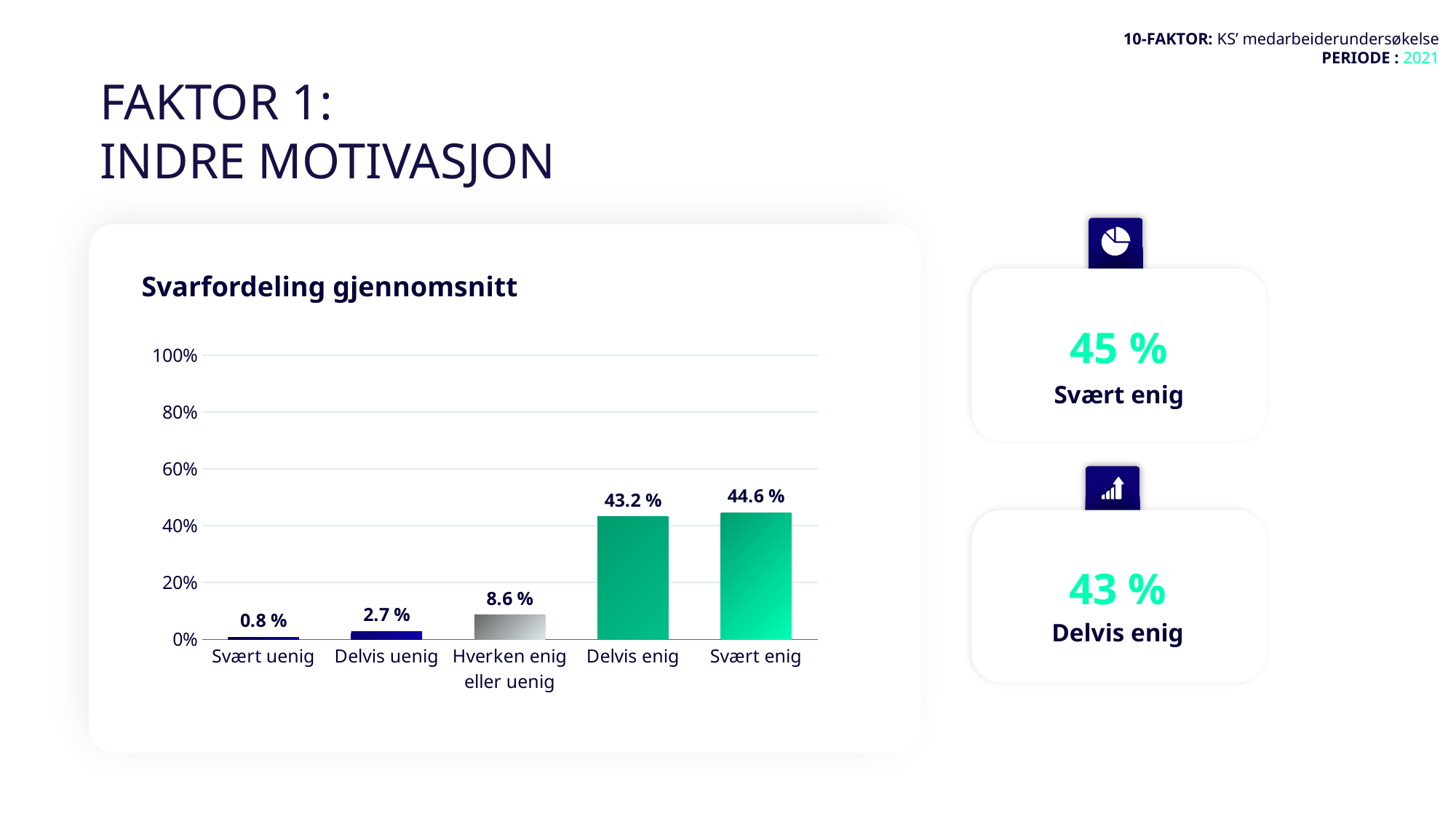
Which category has the lowest value? Svært uenig What kind of chart is shown on the slide? bar chart What is the value for Hverken enig eller uenig? 8.6 % What is the value for Svært enig in the Svarfordeling gjennomsnitt chart? 44.6 % How many categories are shown on the x axis of the chart? 5 What is the title of the chart? Svarfordeling gjennomsnitt What is the value for Svært uenig? 0.8 % Which category has the highest value? Svært enig Is the value for Delvis enig greater or less than 40%? greater Which is larger, the value for Hverken enig eller uenig or the value for Delvis uenig? Hverken enig eller uenig What is the value for Delvis uenig? 2.7 % What is the difference between the values for Svært enig and Delvis enig? 1.4 %